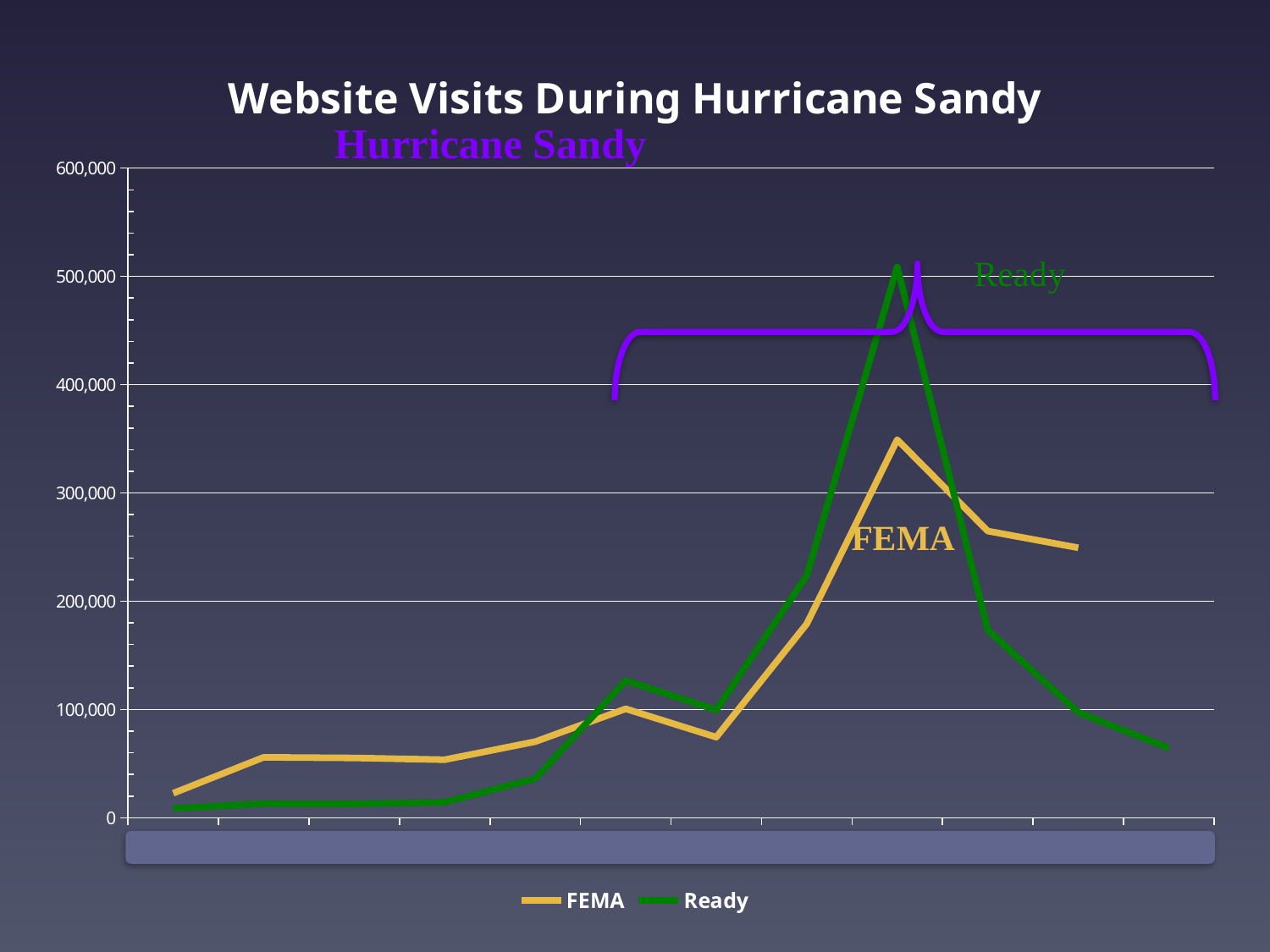
How many series does the legend list? 2 After reaching its peak, does the Ready series rise or fall toward the right end of the x axis? Fall Which colour is used for the Ready series in the legend? Green Which series reaches the higher peak value, FEMA or Ready? Ready Is the last value of the Ready series greater or less than 100,000? less At its peak, is the Ready series higher or lower than the FEMA series at the same point? Higher Is the peak value of the FEMA series greater or less than 400,000? less What is the title of the chart? Website Visits During Hurricane Sandy Is the first value of the FEMA series greater or less than 100,000? less What kind of chart is shown on the slide? Line chart